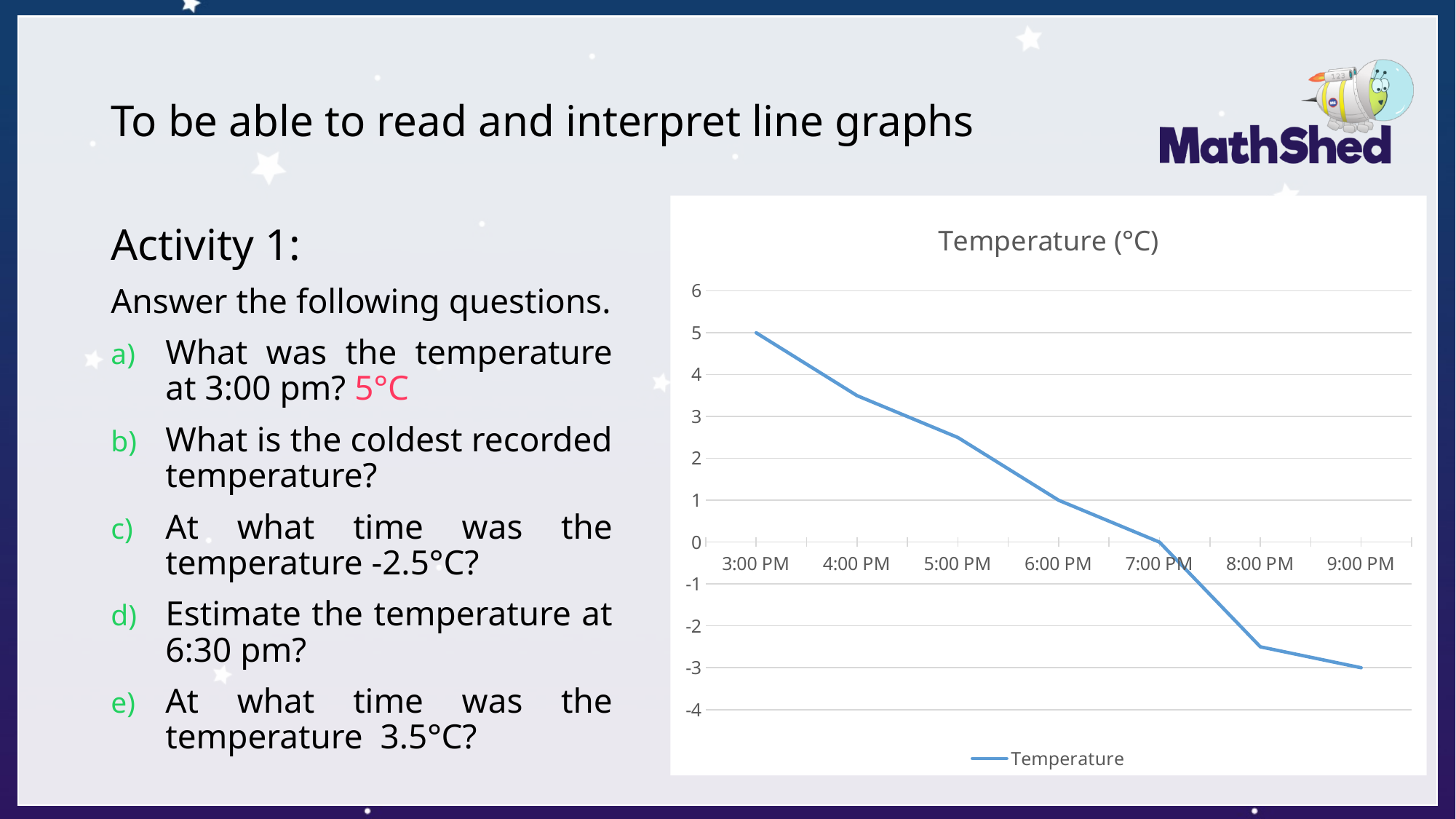
What kind of chart is shown on the slide? line chart What is the temperature at 7:00 PM? 0 Is the temperature at 4:00 PM greater or less than 3? greater At which time is the temperature highest? 3:00 PM How many series does the legend list? 1 What is the temperature at 3:00 PM? 5 What is the title of the chart? Temperature (°C) What is the temperature at 9:00 PM? -3 What is the difference between the temperature at 3:00 PM and at 9:00 PM? 8 Do the temperature values rise or fall from 3:00 PM to 9:00 PM? fall At which time is the temperature lowest? 9:00 PM How many time points are plotted on the chart? 7